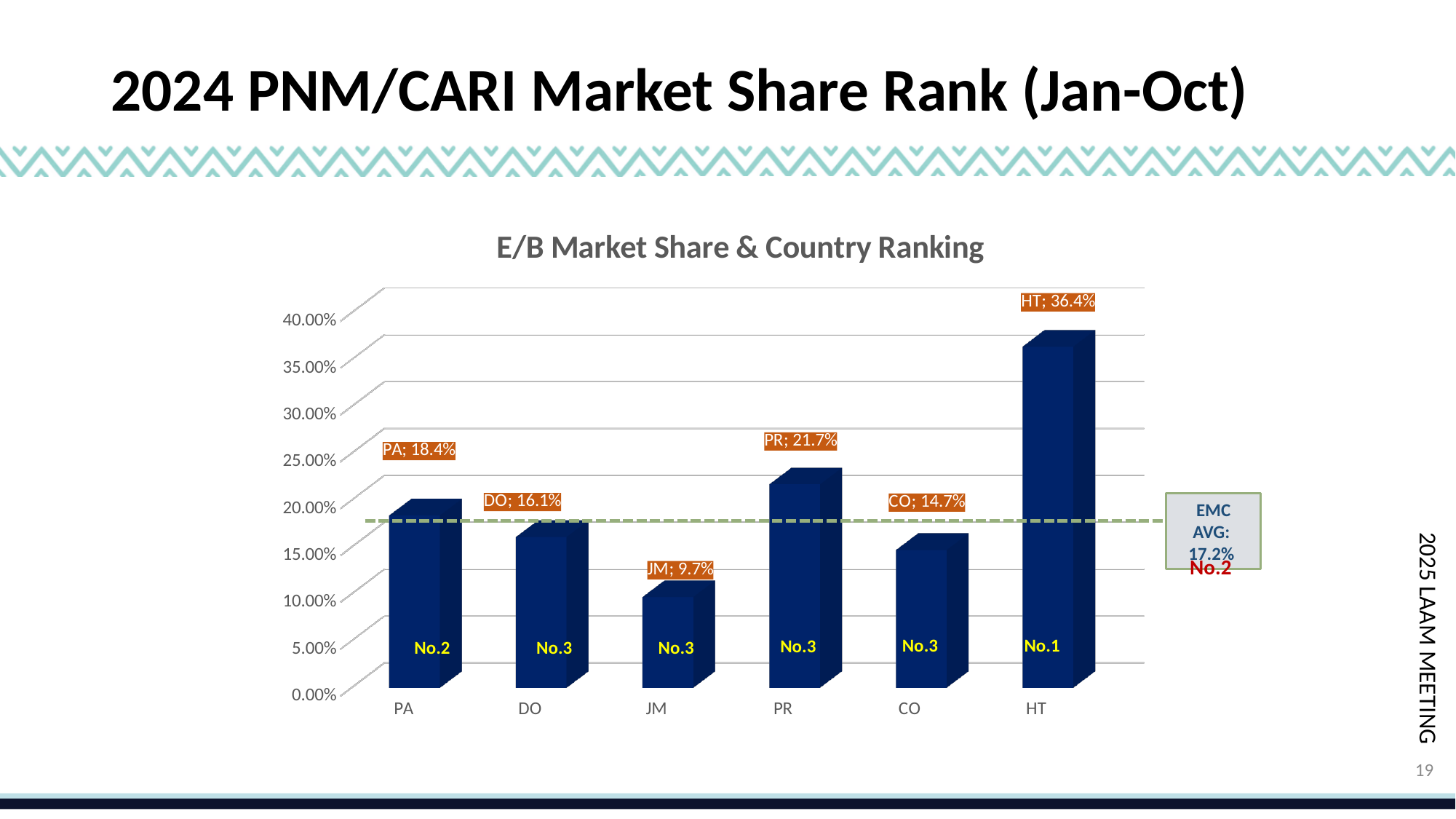
What is the title of the chart? E/B Market Share & Country Ranking How many countries are shown on the chart? 6 Which country has the lowest E/B market share? JM What is the E/B market share for JM? 9.7% What is the E/B market share for PR? 21.7% What country ranking is shown on the HT bar? No.1 Which country has the highest E/B market share? HT What is the EMC average market share shown on the chart? 17.2% What is the difference between the market share of HT and PR? 14.7% What kind of chart is shown on the slide? Bar chart Which has a larger market share, PA or DO? PA What is the E/B market share for HT? 36.4%